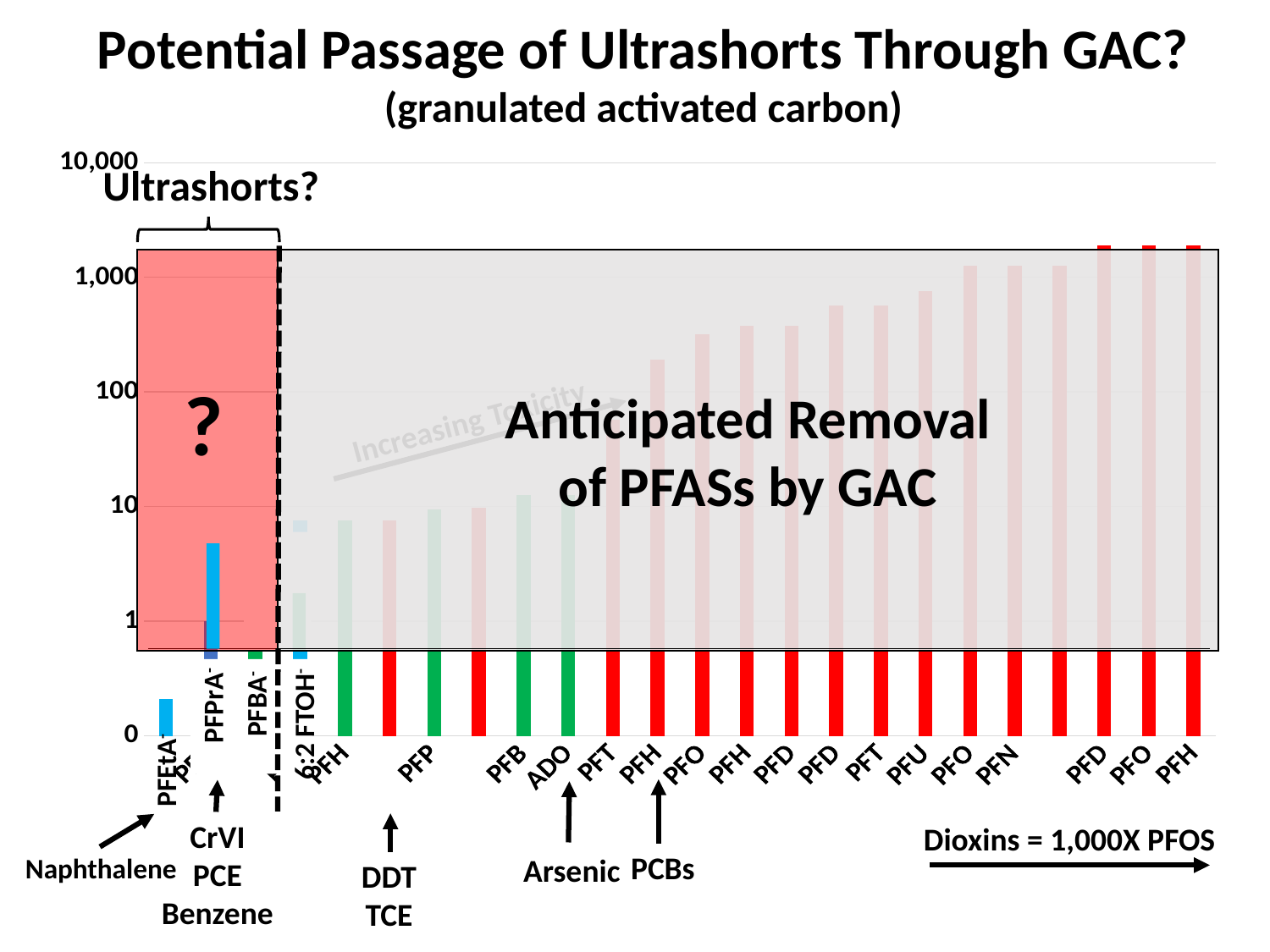
What kind of chart is shown on the slide? bar chart Is the value of the rightmost bar (PFH) greater or less than 1,000? greater What is the title of the chart on the slide? Potential Passage of Ultrashorts Through GAC? Is the value for PFPrA greater or less than 10? less What is the highest value labelled on the y axis? 10,000 Which is larger, the value for PFPrA or the value of the rightmost bar (PFH)? the rightmost bar (PFH) Do the bar values generally rise or fall moving from left to right along the x axis? rise Is the value for PFPrA greater or less than 1? greater What text is written across the grey shaded region of the chart? Anticipated Removal of PFASs by GAC